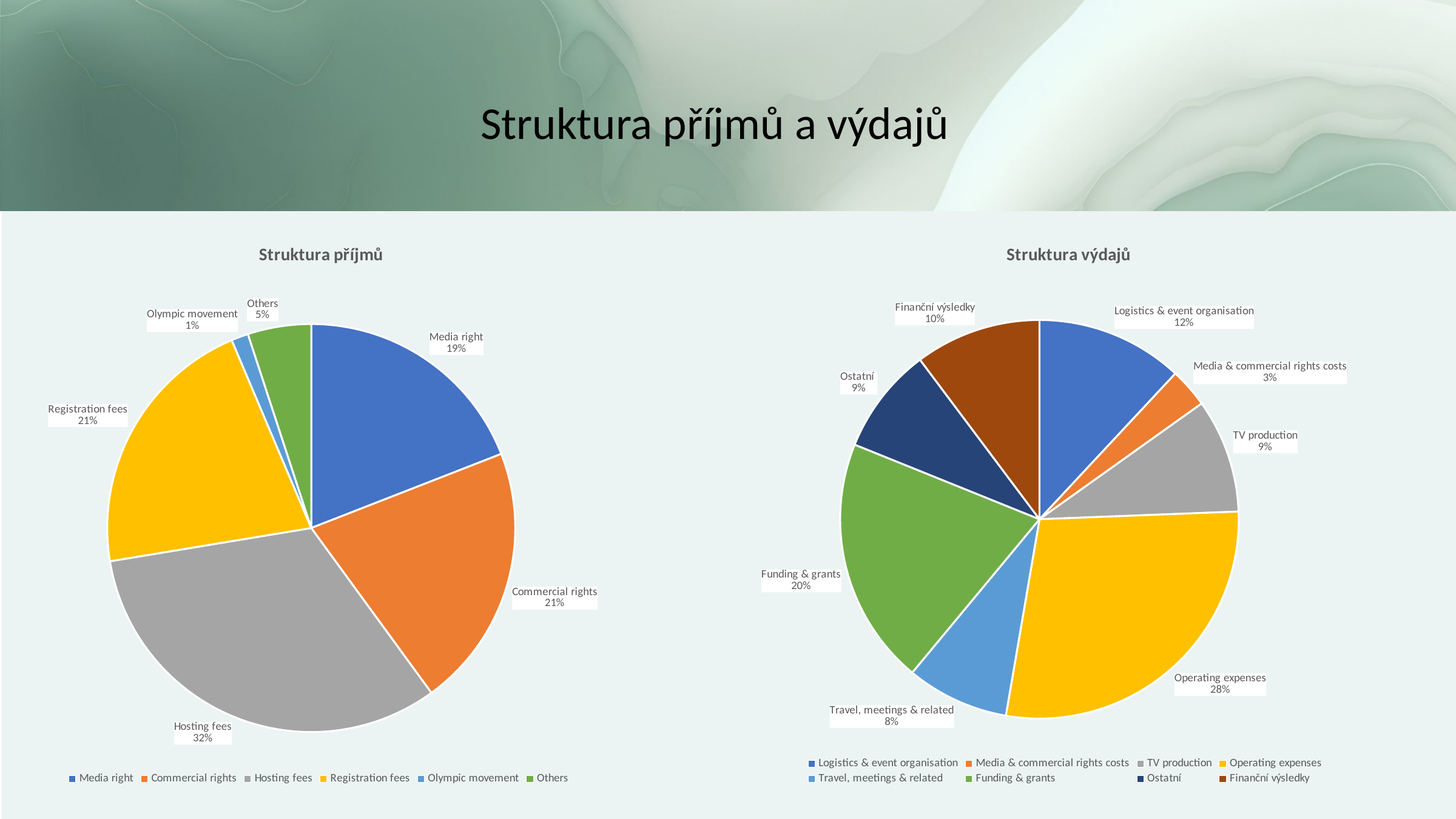
In the "Struktura příjmů" chart, which category has the largest share? Hosting fees In the "Struktura příjmů" chart, what share does Hosting fees have? 32% In the "Struktura výdajů" chart, what colour is the Operating expenses slice? Yellow What type of chart is "Struktura příjmů"? Pie chart In the "Struktura příjmů" chart, which category has the smallest share? Olympic movement In the "Struktura výdajů" chart, which category has the smallest share? Media & commercial rights costs In the "Struktura výdajů" chart, what is the difference between the shares of Operating expenses and Funding & grants? 8% In the "Struktura výdajů" chart, which is larger: Funding & grants or Logistics & event organisation? Funding & grants In the "Struktura příjmů" chart, what is the difference between the shares of Hosting fees and Media right? 13% In the "Struktura výdajů" chart, what share does Operating expenses have? 28% In the "Struktura výdajů" chart, how many categories does the legend list? 8 In the "Struktura příjmů" chart, how many categories are shown? 6